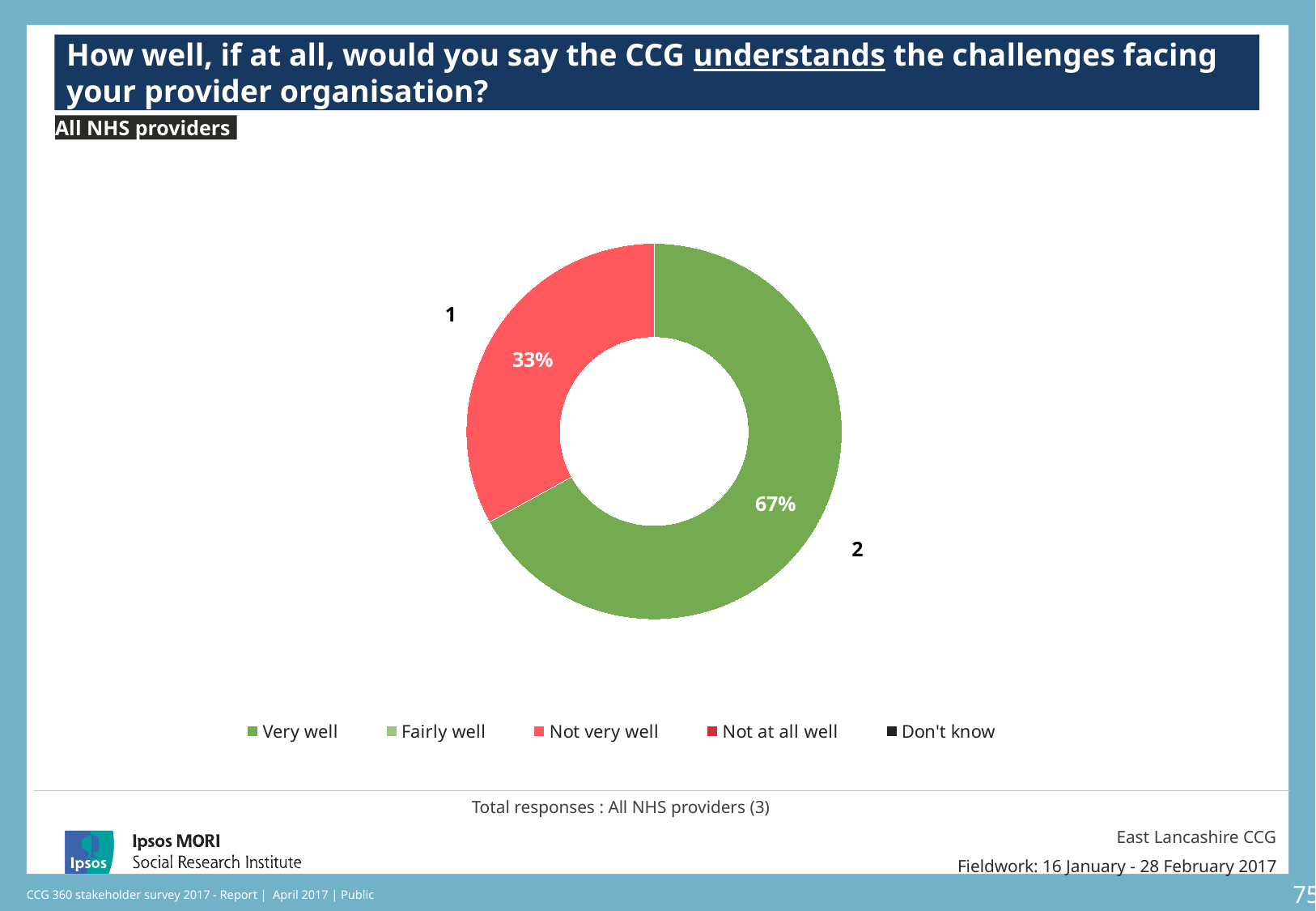
How many slices does the pie chart have? 2 How many response categories does the legend list? 5 What kind of chart is shown on the slide? pie chart (donut) What is the total number of responses shown below the chart? 3 What percentage of the pie is the 'Not very well' slice? 33% Is the share for 'Very well' greater or less than 50%? greater Which response category has the smallest slice of the pie? Not very well By how many percentage points is the 'Very well' slice larger than the 'Not very well' slice? 34 percentage points Which response category has the largest slice of the pie? Very well What percentage of the pie is the 'Very well' slice? 67% Which is larger, the 'Very well' slice or the 'Not very well' slice? Very well What number label is printed next to the green 'Very well' slice? 2